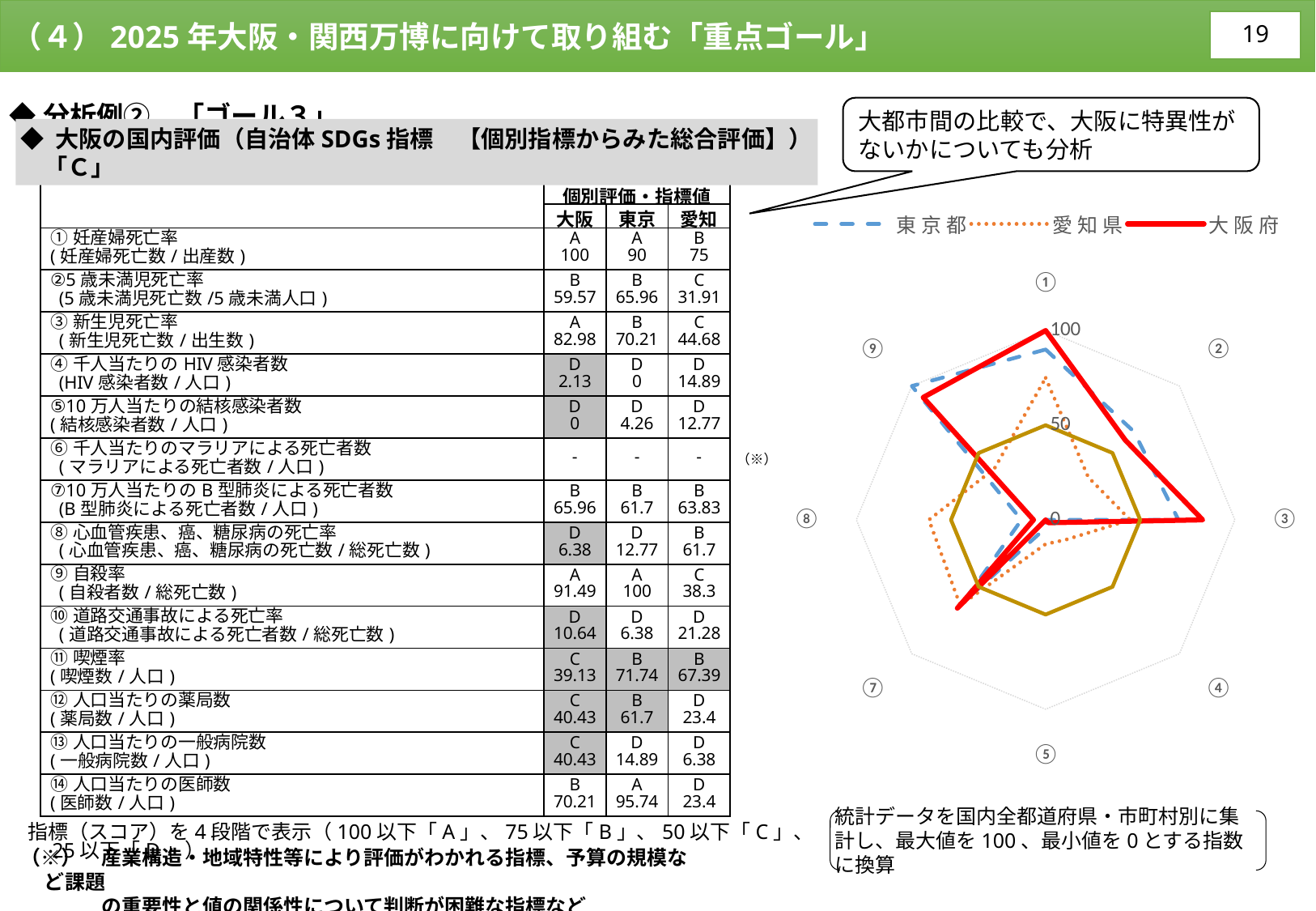
Which series in the radar chart is drawn with a dotted orange line? 愛知県 In the radar chart, which series has the larger value on axis ③, 大阪府 or 愛知県? 大阪府 In the radar chart, is the value for 大阪府 on axis ① greater or less than 50? greater In the radar chart, is the value for 愛知県 on axis ④ greater or less than 50? less Which series in the radar chart is drawn with a solid red line? 大阪府 In the radar chart, is the value for 東京都 on axis ④ greater or less than 50? less What kind of chart is shown on the right side of the slide? radar chart In the radar chart, which series has the highest value on axis ③? 大阪府 How many series does the legend of the radar chart list? 3